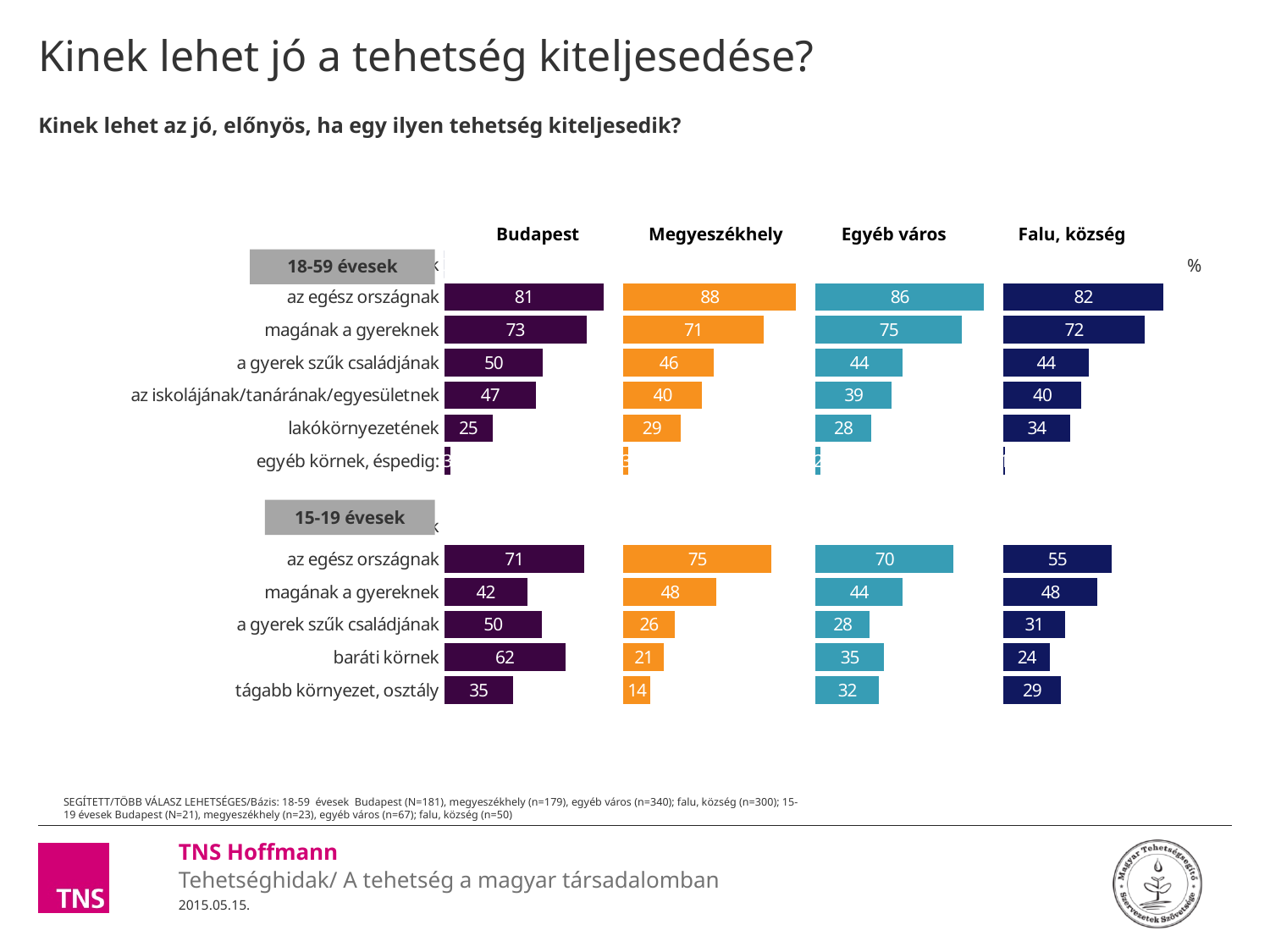
In the Falu, község chart, what is the value for 'lakókörnyezetének' among 18-59 évesek? 34 What are the four column headings above the charts? Budapest, Megyeszékhely, Egyéb város, Falu, község For 'az egész országnak' among 15-19 évesek, which is larger: the Megyeszékhely value or the Falu, község value? Megyeszékhely In the Budapest chart for 15-19 évesek, which category has the highest value? az egész országnak In the Egyéb város chart, what is the value for 'baráti körnek' among 15-19 évesek? 35 In the Egyéb város chart for 18-59 évesek, what is the difference between 'a gyerek szűk családjának' and 'lakókörnyezetének'? 16 In the Megyeszékhely chart for 15-19 évesek, which category has the lowest value? tágabb környezet, osztály In the Budapest chart, what is the value for 'az egész országnak' among 18-59 évesek? 81 In the Megyeszékhely chart, what is the value for 'magának a gyereknek' among 15-19 évesek? 48 In the Budapest chart for 18-59 évesek, what is the difference between 'az egész országnak' and 'magának a gyereknek'? 8 How many categories are shown in the 15-19 évesek section of each chart? 5 What kind of chart is used on this slide? bar chart